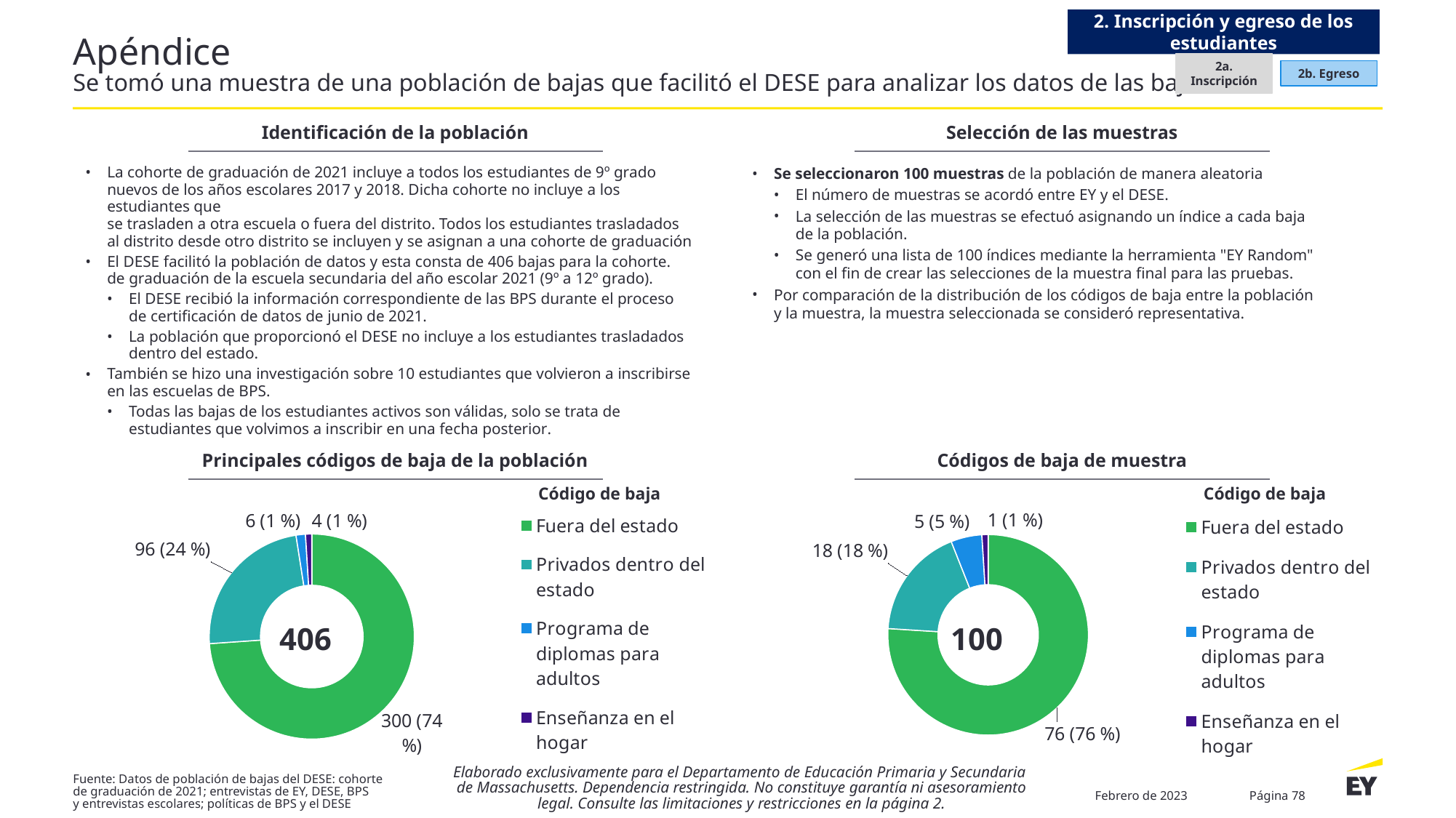
In the chart 'Códigos de baja de muestra', which category has the largest value? Fuera del estado In the chart 'Principales códigos de baja de la población', what is the total shown in the centre of the donut? 406 In the chart 'Códigos de baja de muestra', what share of the pie does 'Privados dentro del estado' represent? 18 % In the chart 'Principales códigos de baja de la población', what is the value for 'Fuera del estado'? 300 (74 %) What kind of chart is 'Principales códigos de baja de la población'? Pie chart (donut) In the chart 'Códigos de baja de muestra', which is larger: 'Privados dentro del estado' or 'Programa de diplomas para adultos'? Privados dentro del estado How many categories does the legend of the chart 'Códigos de baja de muestra' list? 4 In the chart 'Códigos de baja de muestra', what is the value for 'Programa de diplomas para adultos'? 5 (5 %) In the chart 'Principales códigos de baja de la población', what is the difference between 'Fuera del estado' and 'Privados dentro del estado'? 204 In the chart 'Principales códigos de baja de la población', what is the value for 'Privados dentro del estado'? 96 (24 %) In the chart 'Principales códigos de baja de la población', which category has the smallest value? Enseñanza en el hogar In the chart 'Códigos de baja de muestra', what is the value for 'Fuera del estado'? 76 (76 %)